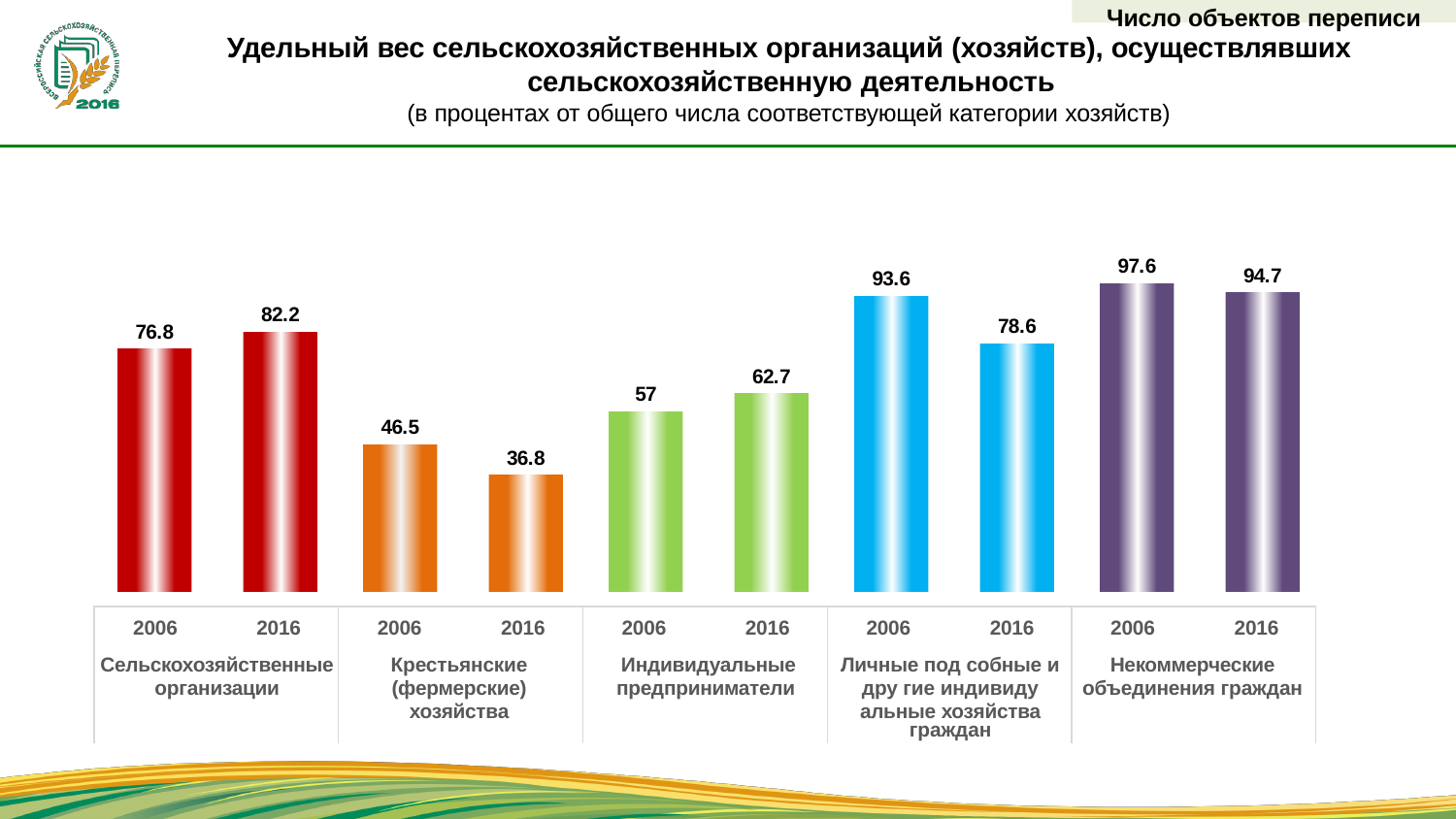
Did the value for Крестьянские (фермерские) хозяйства rise or fall from 2006 to 2016? Fall What is the value for Некоммерческие объединения граждан in 2016? 94.7 Which bar has the highest value on the chart? Некоммерческие объединения граждан, 2006 (97.6) Which is larger: the 2016 value for Индивидуальные предприниматели or the 2016 value for Крестьянские (фермерские) хозяйства? Индивидуальные предприниматели (62.7) By how much did the value for Личные подсобные и другие индивидуальные хозяйства граждан fall from 2006 to 2016? 15 What is the value for Крестьянские (фермерские) хозяйства in 2016? 36.8 What is the difference between the 2016 and 2006 values for Сельскохозяйственные организации? 5.4 Which bar has the lowest value on the chart? Крестьянские (фермерские) хозяйства, 2016 (36.8) What is the value for Сельскохозяйственные организации in 2006? 76.8 What type of chart is shown on the slide? Bar chart How many categories of farms are shown on the chart? 5 What is the value for Индивидуальные предприниматели in 2006? 57